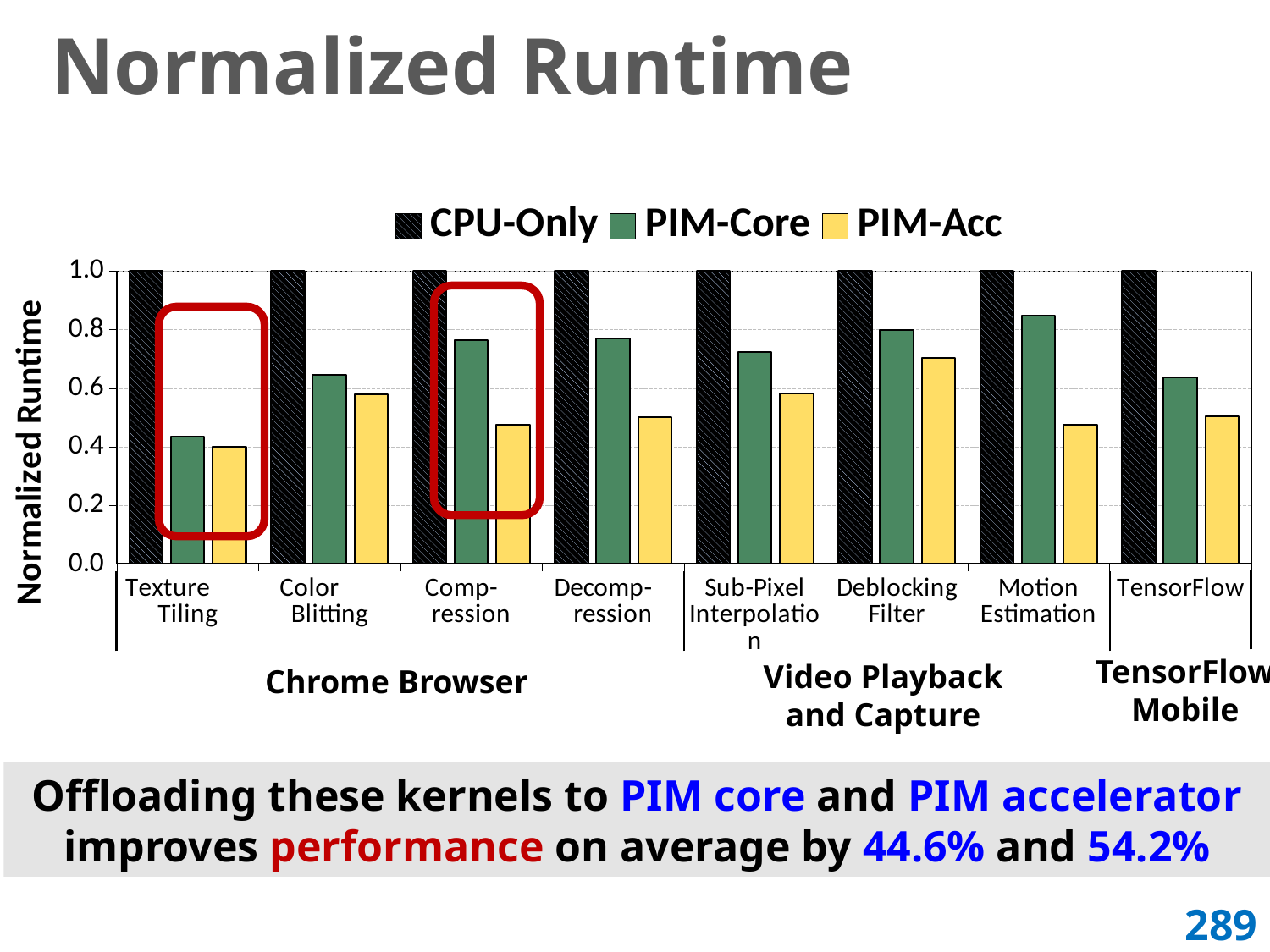
Which two categories are highlighted with red boxes on the chart? Texture Tiling and Compression For Compression, which is larger: the PIM-Core value or the PIM-Acc value? PIM-Core Which category has the lowest PIM-Acc normalized runtime? Texture Tiling Is the PIM-Core value for Texture Tiling greater or less than 0.6? less Which category has the highest PIM-Core normalized runtime? Motion Estimation How many series does the legend list? 3 Which is larger: the PIM-Acc value for Color Blitting or the PIM-Acc value for Texture Tiling? Color Blitting Is the PIM-Core value for Motion Estimation greater or less than 0.6? greater Is the PIM-Acc value for Deblocking Filter greater or less than 0.6? greater What is the CPU-Only normalized runtime for Texture Tiling? 1.0 What kind of chart is shown on the slide? bar chart How many kernel categories are plotted along the x axis? 8